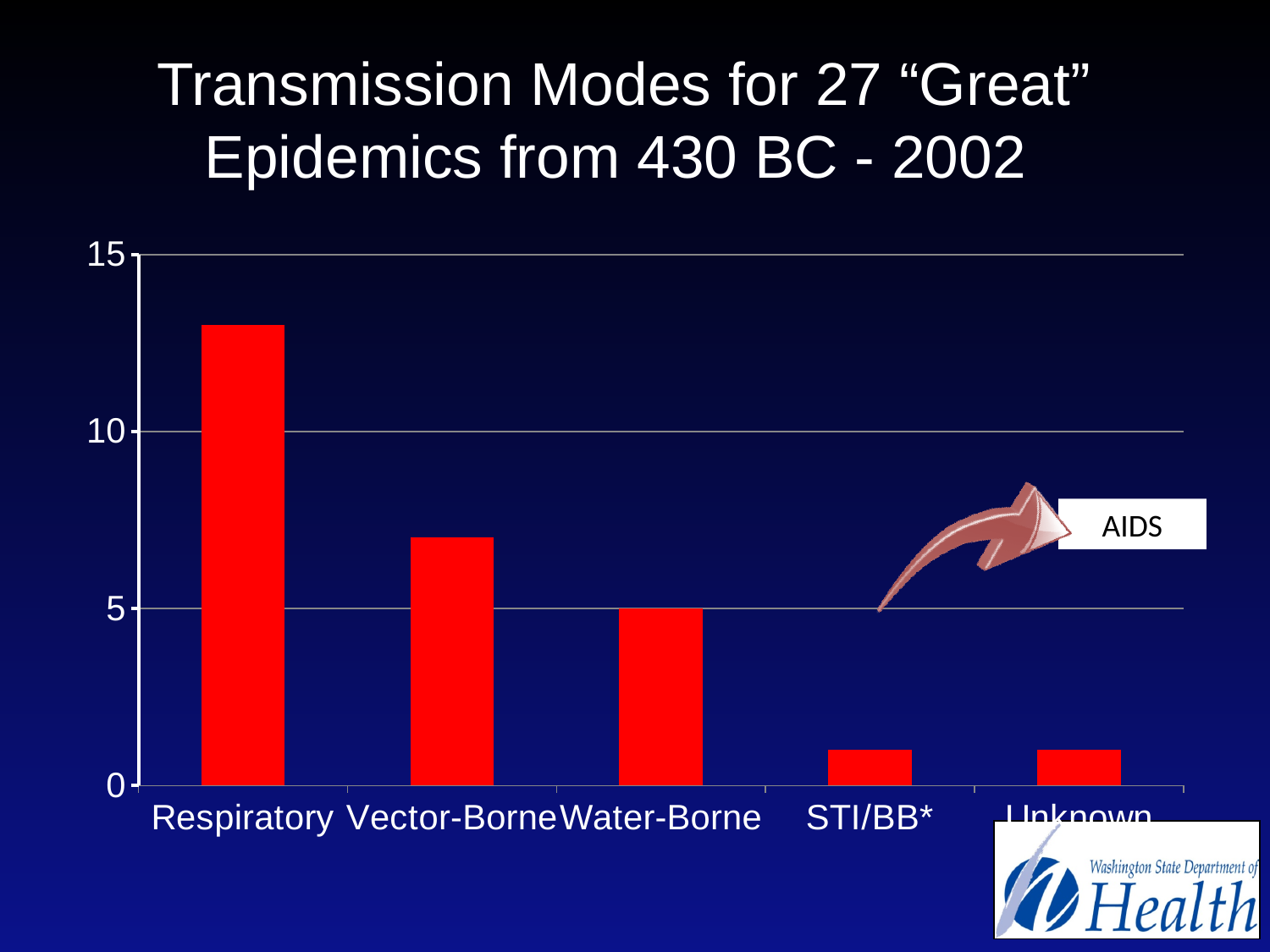
Which category does the arrow labelled "AIDS" point to? STI/BB* Is the value for Respiratory greater or less than 10? greater What is the title of the chart? Transmission Modes for 27 "Great" Epidemics from 430 BC - 2002 Which is larger, the value for Respiratory or the value for Vector-Borne? Respiratory Which is larger, the value for Vector-Borne or the value for Water-Borne? Vector-Borne What is the value for Water-Borne? 5 What kind of chart is shown on the slide? Bar chart Is the value for Vector-Borne greater or less than 5? greater Do the bar values generally rise or fall from left to right along the x axis? Fall Which transmission mode has the highest number of epidemics? Respiratory Is the value for STI/BB* greater or less than 5? less How many transmission mode categories are shown on the x axis? 5